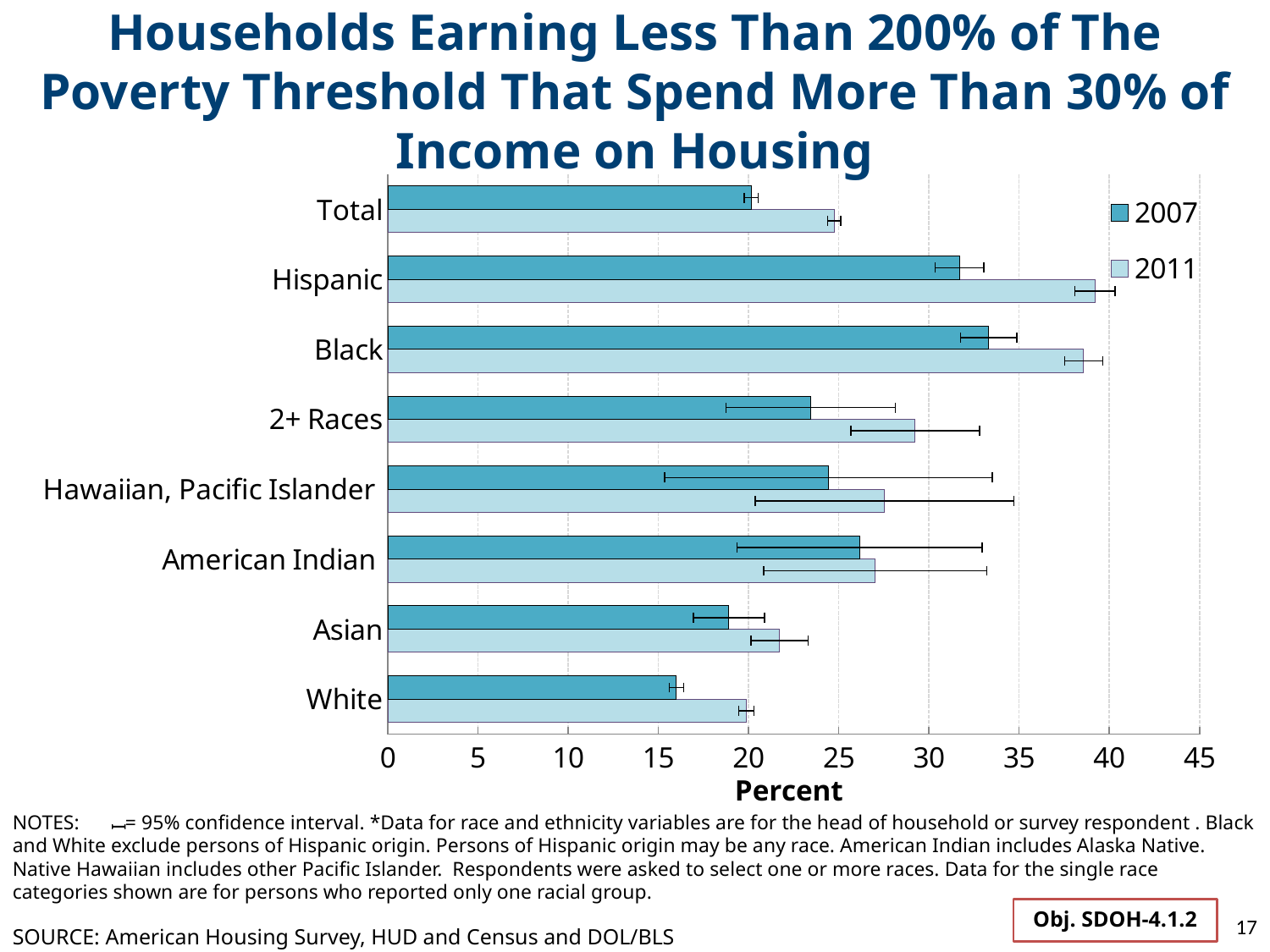
How many categories are shown on the y axis of the chart? 8 Is the 2007 value for Black greater or less than 30? greater What is the title of the x axis? Percent What kind of chart is shown on the slide? bar chart Is the 2007 value for White greater or less than 20? less Which category has the lowest value for 2011? White Is the 2011 value for Hispanic greater or less than 35? greater Which category has the lowest value for 2007? White How many series does the legend list? 2 For Hispanic, which year has the larger value, 2007 or 2011? 2011 For 2007, which is larger, the value for Black or the value for 2+ Races? Black